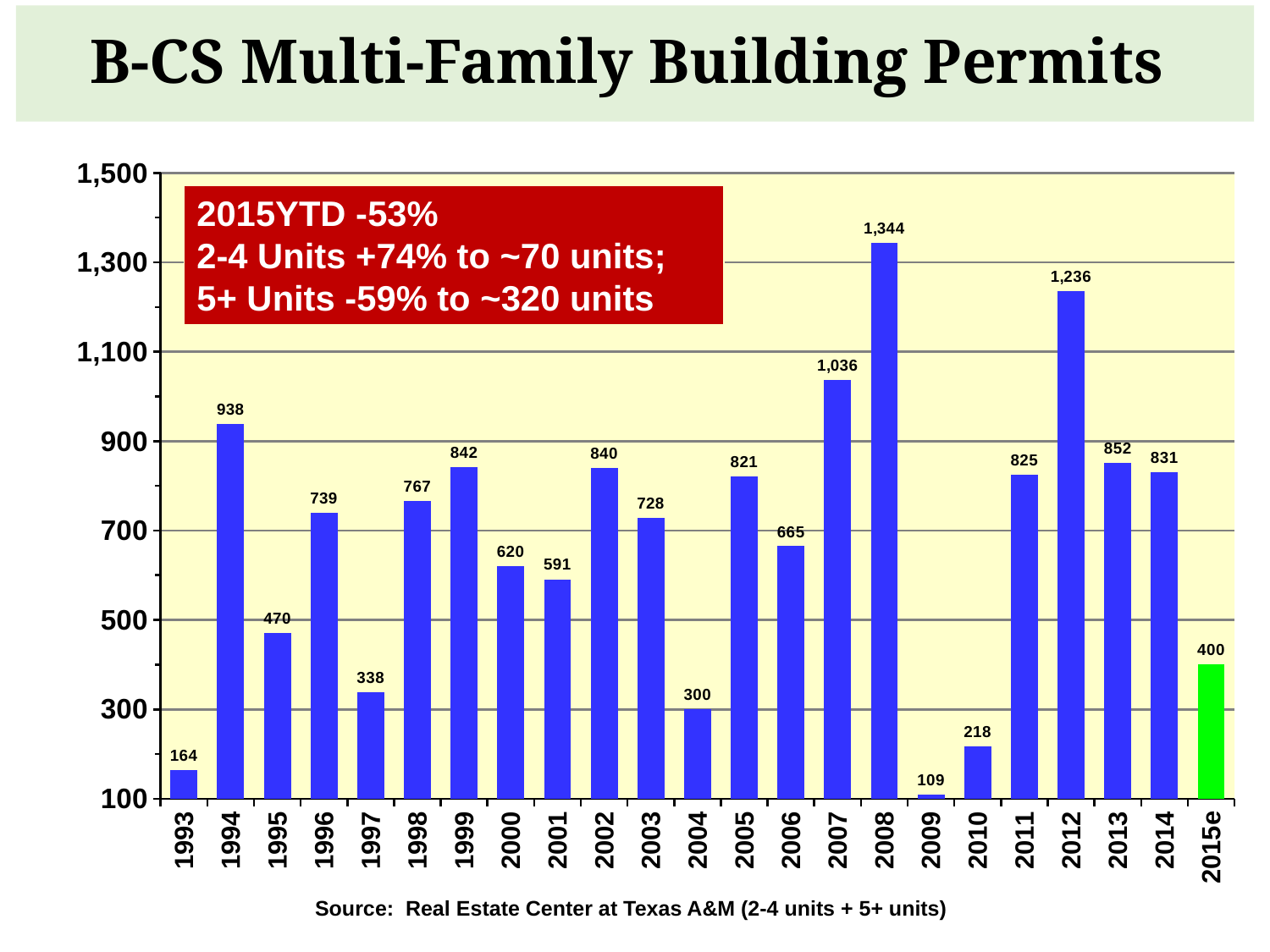
What is the value for 1993? 164 What kind of chart is this? bar chart How many years are shown on the x axis? 23 What is the value for 2008? 1,344 Which year has the highest value? 2008 Do the values rise or fall from 2009 to 2012? rise What is the difference between the values for 2008 and 2012? 108 What colour is the bar for 2015e? green What is the value for 2015e? 400 Which year has the lowest value? 2009 Which is larger, the value for 2007 or the value for 2011? 2007 Is the value for 2004 greater or less than 500? less